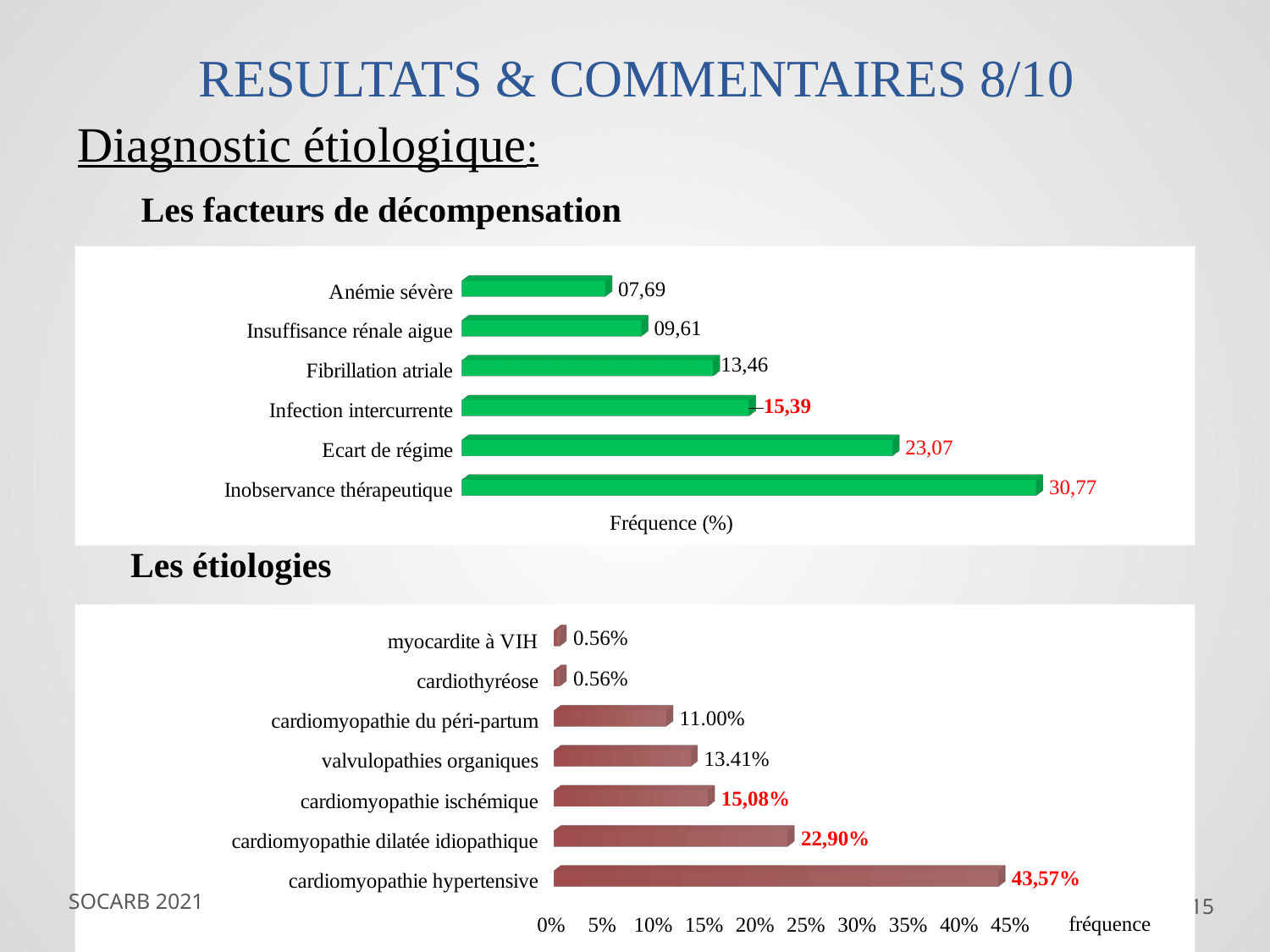
In the 'Les facteurs de décompensation' chart, what is the value for Inobservance thérapeutique? 30,77 In the 'Les facteurs de décompensation' chart, what is the label of the horizontal axis? Fréquence (%) In the 'Les facteurs de décompensation' chart, what is the value for Fibrillation atriale? 13,46 In the 'Les facteurs de décompensation' chart, what is the difference between Inobservance thérapeutique and Ecart de régime? 7,70 What type of chart is 'Les étiologies'? Bar chart In the 'Les étiologies' chart, which is larger: cardiomyopathie ischémique or cardiomyopathie du péri-partum? cardiomyopathie ischémique In the 'Les facteurs de décompensation' chart, which category has the lowest value? Anémie sévère In the 'Les étiologies' chart, how many categories are shown? 7 In the 'Les étiologies' chart, what is the value for cardiomyopathie hypertensive? 43,57% In the 'Les étiologies' chart, which category has the highest value? cardiomyopathie hypertensive In the 'Les facteurs de décompensation' chart, how many categories are shown? 6 In the 'Les étiologies' chart, what is the value for valvulopathies organiques? 13.41%